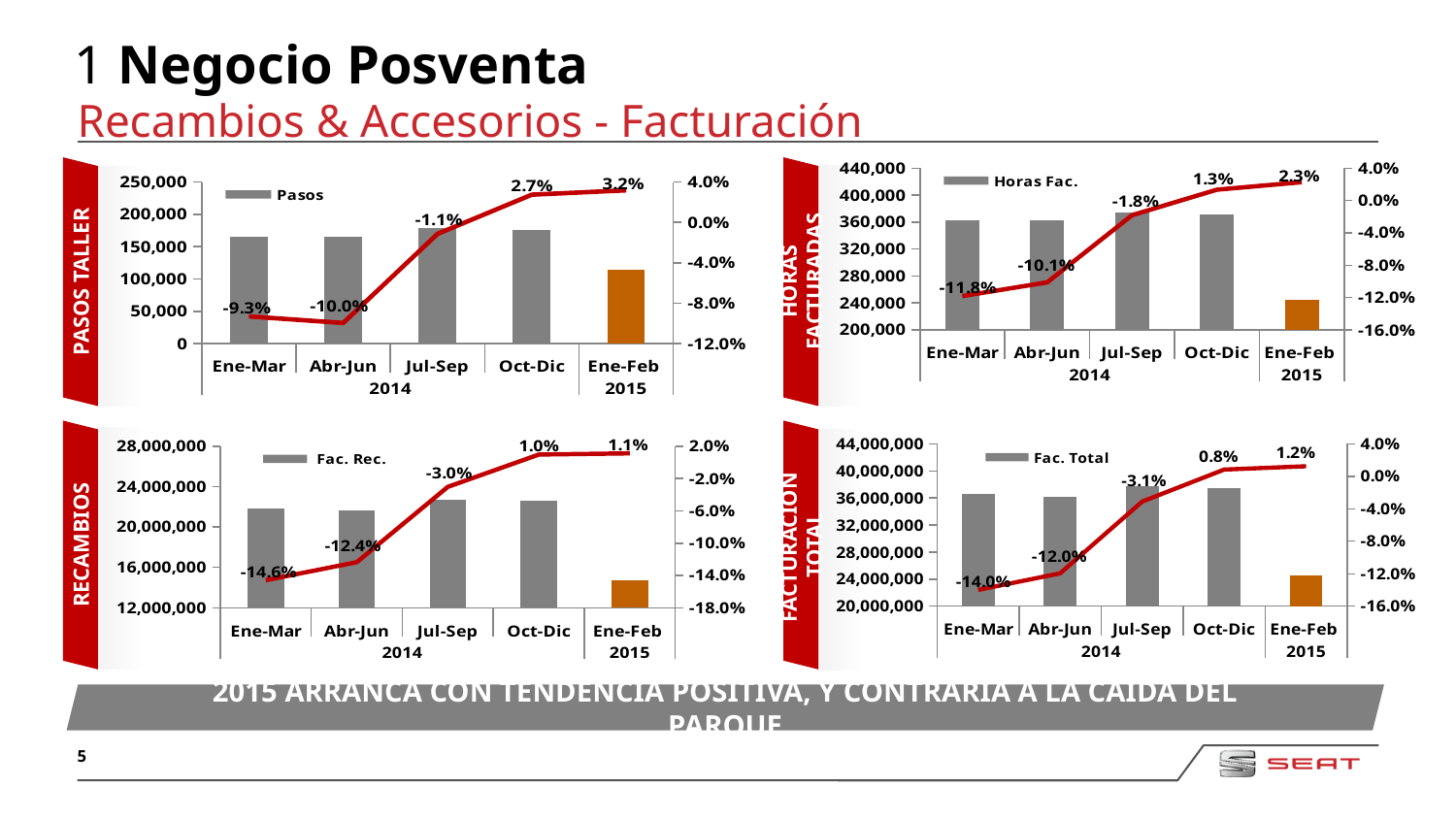
In the RECAMBIOS chart (bottom left), is the Fac. Rec. bar for Ene-Feb 2015 greater or less than 16,000,000? less In the PASOS TALLER chart (top left), what is the percentage value shown for Oct-Dic 2014? 2.7% In the PASOS TALLER chart (top left), is the Pasos bar for Ene-Mar 2014 greater or less than 150,000? greater In the PASOS TALLER chart (top left), which period has the lowest percentage value on the line? Abr-Jun 2014 In the FACTURACIÓN TOTAL chart (bottom right), what is the percentage value shown for Jul-Sep 2014? -3.1% In the RECAMBIOS chart (bottom left), which is larger, the percentage value for Ene-Mar 2014 or for Abr-Jun 2014? Abr-Jun 2014 In the HORAS FACTURADAS chart (top right), what is the difference between the percentage values for Ene-Feb 2015 and Oct-Dic 2014? 1.0% In the FACTURACIÓN TOTAL chart (bottom right), do the percentage values on the line rise or fall from Ene-Mar 2014 to Ene-Feb 2015? rise In the RECAMBIOS chart (bottom left), what is the percentage value shown for Ene-Feb 2015? 1.1% How many periods are shown on the x axis of the HORAS FACTURADAS chart (top right)? 5 In the HORAS FACTURADAS chart (top right), what is the percentage value shown for Ene-Mar 2014? -11.8% In the FACTURACIÓN TOTAL chart (bottom right), which period has the highest percentage value on the line? Ene-Feb 2015